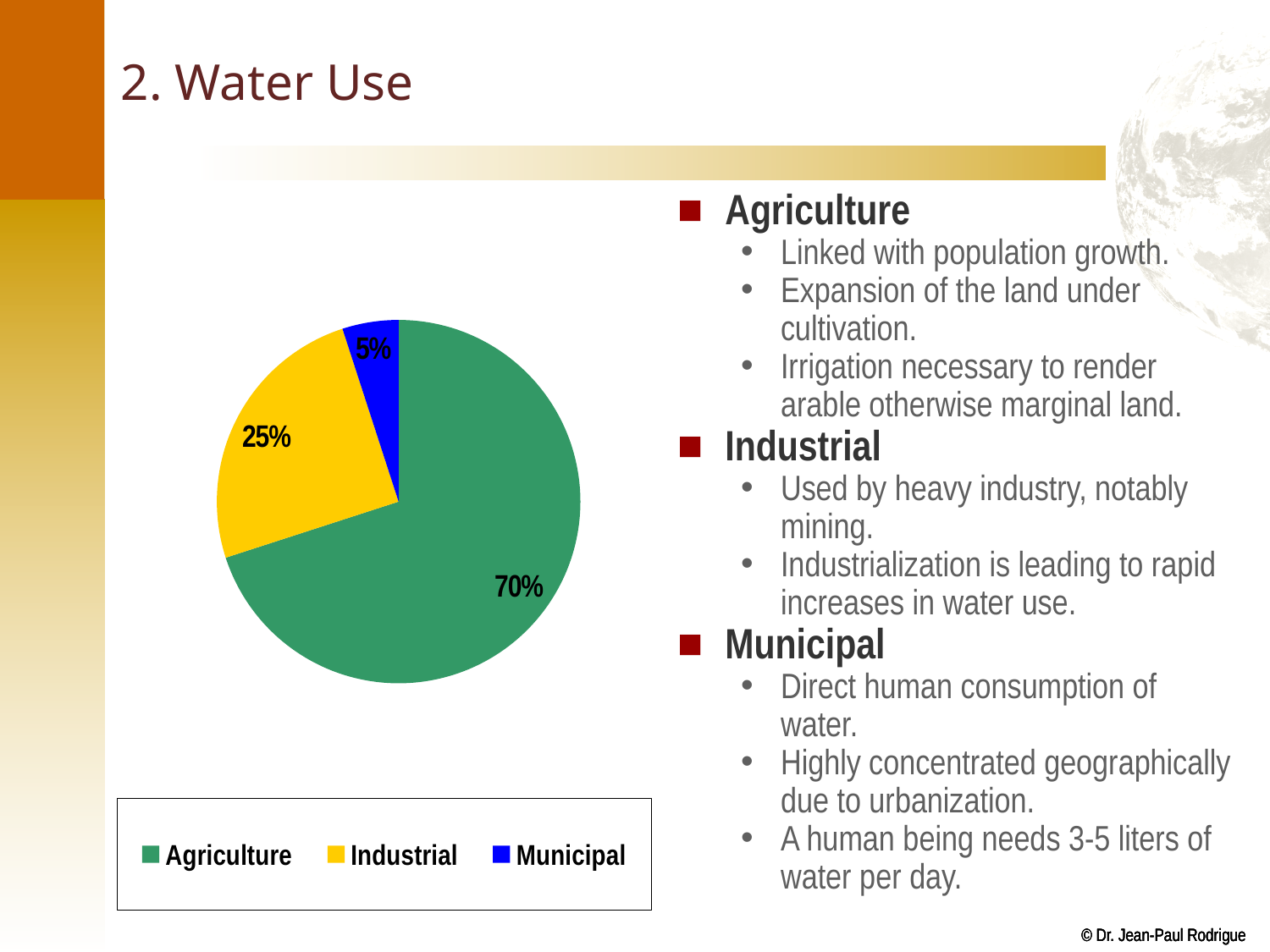
What is the difference in percentage points between the Industrial and Municipal slices? 20 Which category has the largest slice of the pie chart? Agriculture What share of water use does Industrial account for in the pie chart? 25% What share of water use does Agriculture account for in the pie chart? 70% What is the difference in percentage points between the Agriculture and Industrial slices? 45 Which is larger in the pie chart, Industrial or Municipal? Industrial What kind of chart is shown on the slide? pie chart How many categories are shown in the pie chart? 3 What colour is the Agriculture slice in the pie chart? green Which category has the smallest slice of the pie chart? Municipal What are the three entries listed in the chart legend? Agriculture, Industrial, Municipal What share of water use does Municipal account for in the pie chart? 5%